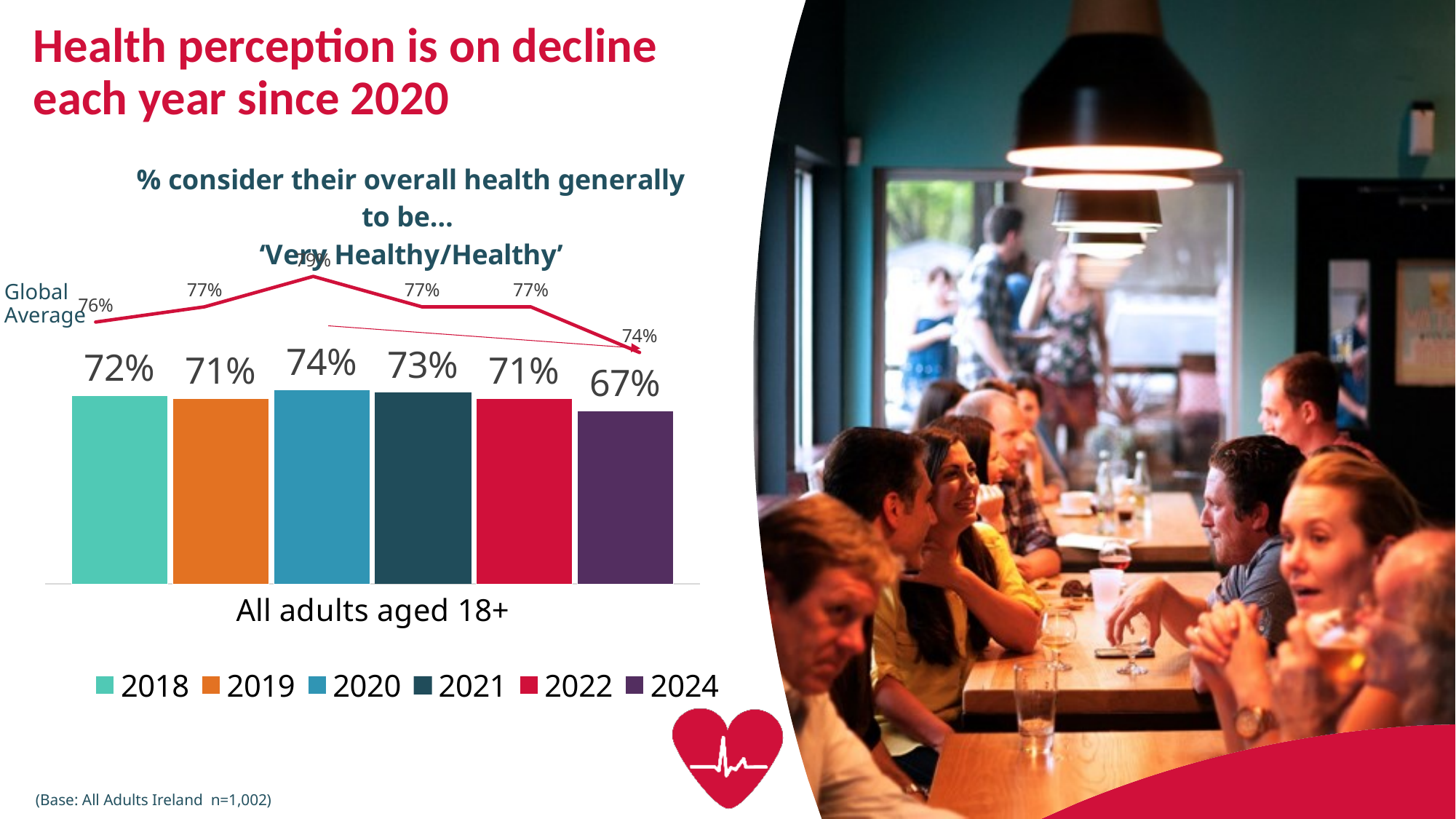
What is the difference between the 2020 bar value and the 2024 bar value? 7% What is the Global Average value shown for 2024? 74% How many years are listed in the chart legend? 6 Which year has the highest bar in the chart? 2020 Which year has the lowest bar in the chart? 2024 What colour is the bar for 2019? Orange What type of chart is used to show the 'Very Healthy/Healthy' percentages by year? Bar chart What is the value shown for 2020 in the bar chart? 74% Do the bar values rise or fall from 2020 to 2024? Fall Which is larger, the bar value for 2018 or the bar value for 2021? 2021 What is the Global Average value shown for 2018? 76% What percentage of all adults aged 18+ considered their overall health to be 'Very Healthy/Healthy' in 2024? 67%